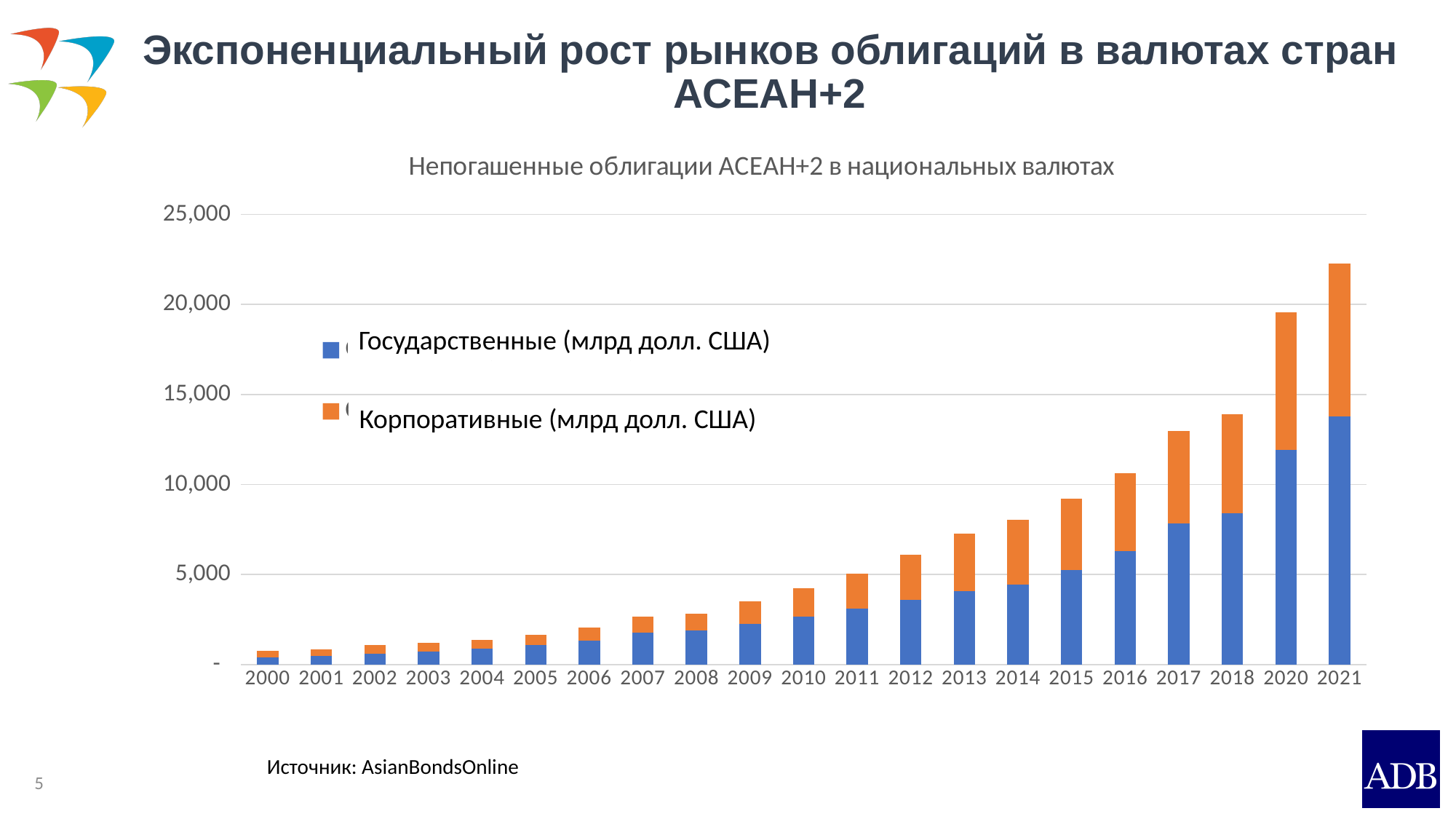
Which year has the lowest total bar? 2000 Do the total bar values rise or fall from 2000 to 2021? Rise Which series is shown in orange? Корпоративные (млрд долл. США) In 2021, which is larger: the Государственные segment or the Корпоративные segment? Государственные What kind of chart is shown on the slide? Stacked bar chart What is the title of the chart? Непогашенные облигации АСЕАН+2 в национальных валютах Is the Государственные (blue) value for 2021 greater or less than 10,000? greater Is the total bar for 2021 greater or less than 20,000? greater How many series does the legend list? 2 How many years are shown on the x axis? 21 Which year has the highest total bar? 2021 Is the total bar for 2015 greater or less than 10,000? less